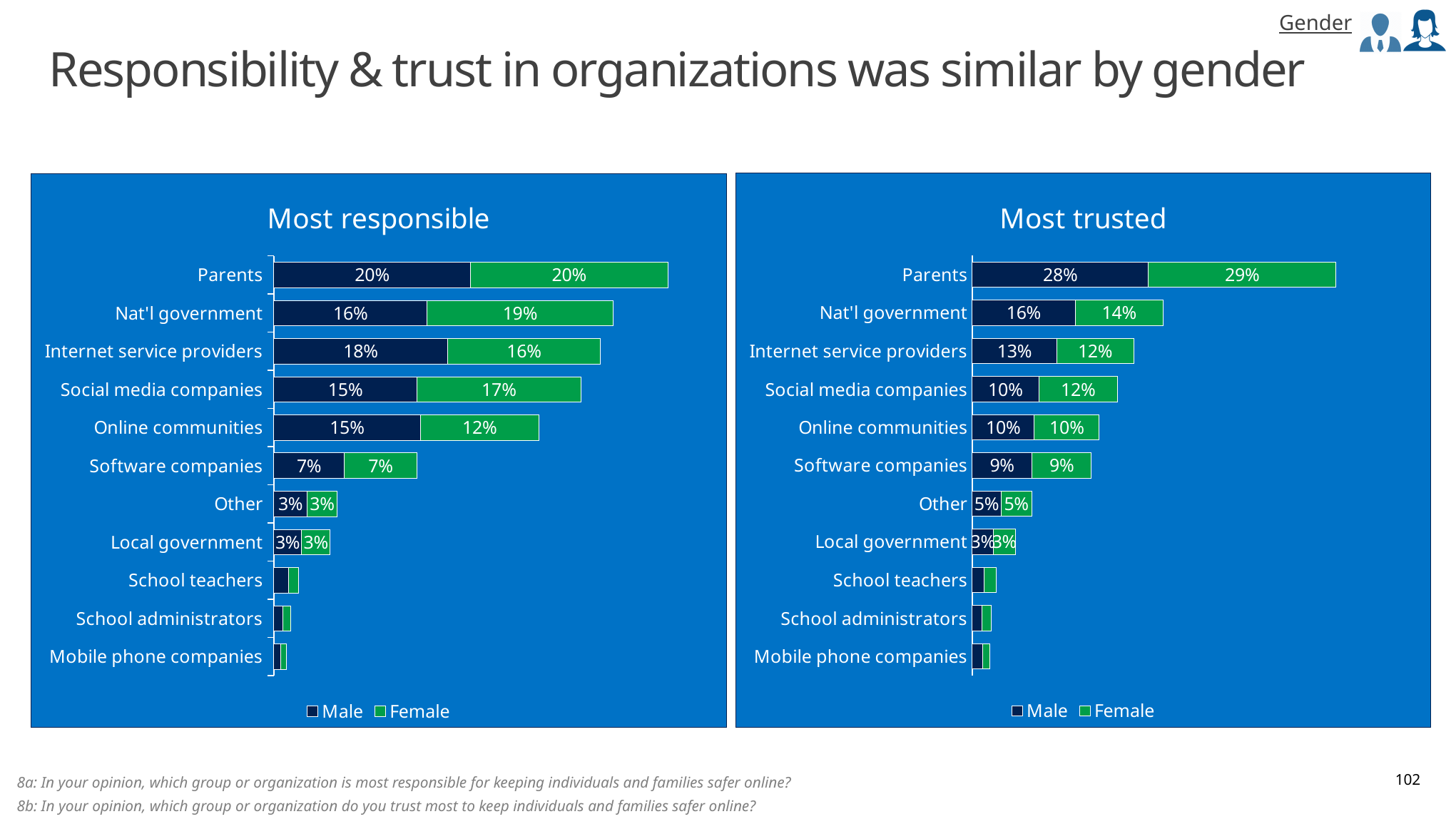
In the 'Most trusted' chart, which category has the highest Female value? Parents How many series does the legend of the 'Most trusted' chart list? 2 How many categories are shown in the 'Most responsible' chart? 11 In the 'Most trusted' chart, which is larger for Nat'l government: the Male value or the Female value? Male What type of chart is the 'Most responsible' chart? Stacked bar chart In the 'Most responsible' chart, what is the Female value for Nat'l government? 19% In the 'Most responsible' chart, which category has the highest Male value? Parents In the 'Most trusted' chart, what is the total of the stacked bar for Parents? 57% In the 'Most trusted' chart, what is the Female value for Social media companies? 12% In the 'Most trusted' chart, what is the Male value for Parents? 28% In the 'Most responsible' chart, what is the difference between the Male and Female values for Online communities? 3% In the 'Most responsible' chart, is the Male value for Internet service providers larger or smaller than the Female value? larger